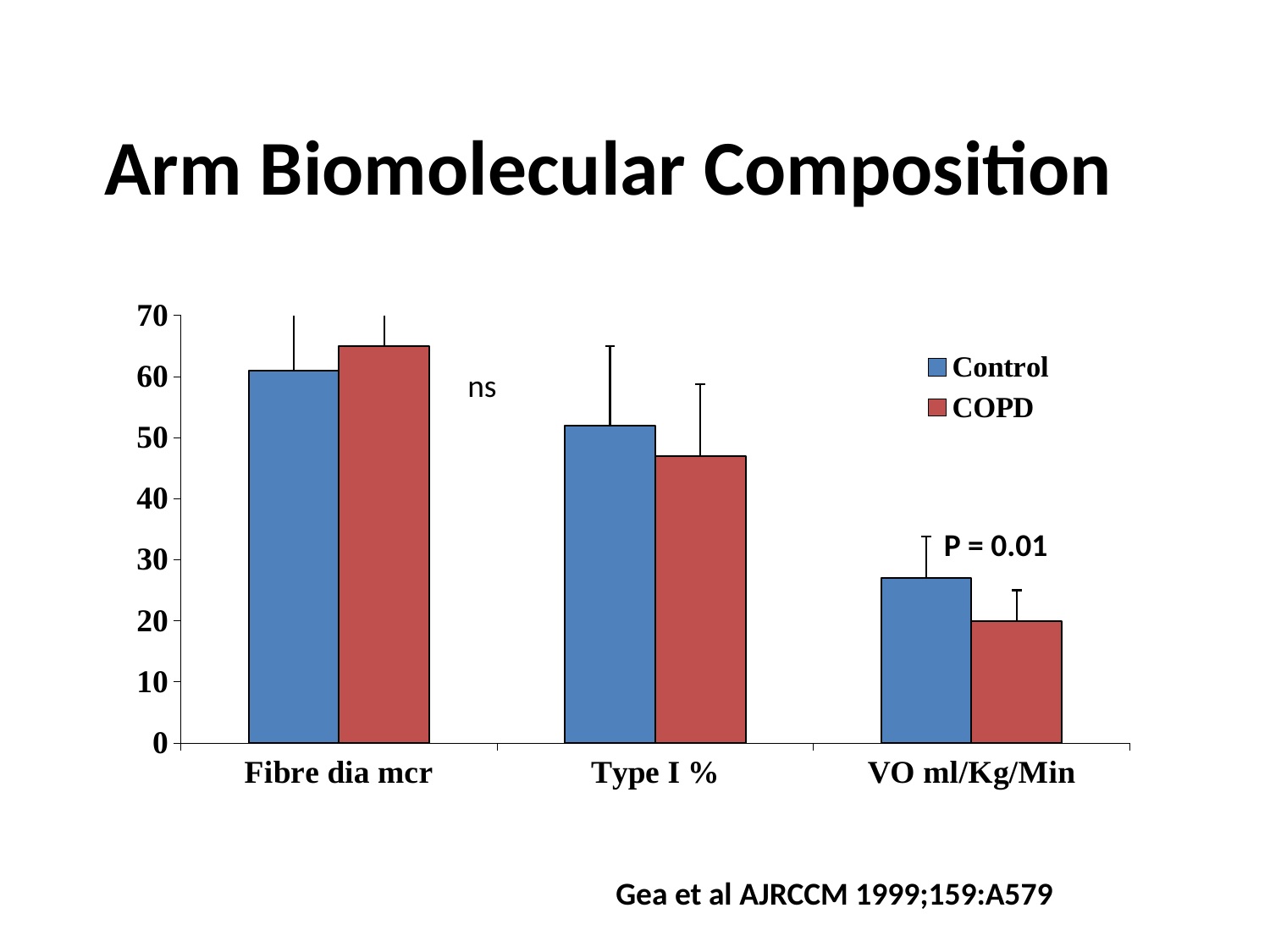
For Fibre dia mcr, which series has the larger value, Control or COPD? COPD Which category has the highest Control value? Fibre dia mcr What are the two series named in the legend? Control and COPD For VO ml/Kg/Min, which series has the larger value, Control or COPD? Control Is the COPD value for Type I % greater or less than 50? less What kind of chart is shown on the slide? bar chart Is the COPD value for Fibre dia mcr greater or less than 60? greater Which category has the lowest COPD value? VO ml/Kg/Min Is the Control value for VO ml/Kg/Min greater or less than 30? less For Type I %, which series has the larger value, Control or COPD? Control How many series does the legend list? 2 How many categories are shown on the x axis? 3